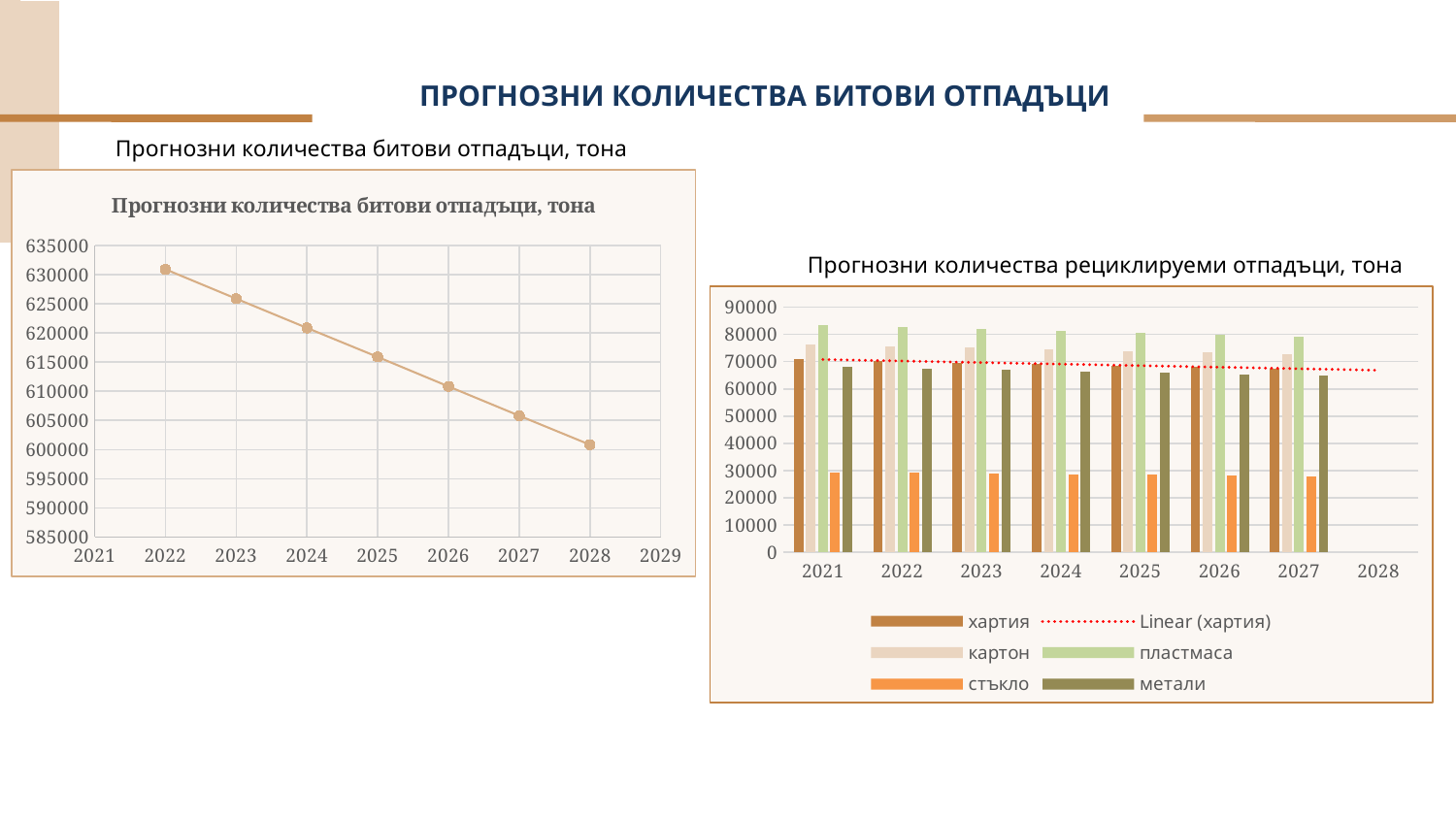
In the left chart 'Прогнозни количества битови отпадъци, тона', is the value for 2025 greater or less than 620000? less In the right chart 'Прогнозни количества рециклируеми отпадъци, тона', which series has the lowest value in 2024? стъкло How many data points are plotted in the left chart 'Прогнозни количества битови отпадъци, тона'? 7 What kind of chart is the right chart titled 'Прогнозни количества рециклируеми отпадъци, тона'? bar chart In the right chart 'Прогнозни количества рециклируеми отпадъци, тона', is the value for пластмаса in 2021 greater or less than 80000? greater In the right chart 'Прогнозни количества рециклируеми отпадъци, тона', which series has the highest value in 2021? пластмаса How many entries does the legend of the right chart 'Прогнозни количества рециклируеми отпадъци, тона' list? 6 What kind of chart is the left chart titled 'Прогнозни количества битови отпадъци, тона'? line chart In the left chart 'Прогнозни количества битови отпадъци, тона', is the value for 2022 greater or less than 630000? greater In the right chart 'Прогнозни количества рециклируеми отпадъци, тона', which is larger in 2027: картон or хартия? картон In the left chart 'Прогнозни количества битови отпадъци, тона', do the values rise or fall from 2022 to 2028? fall